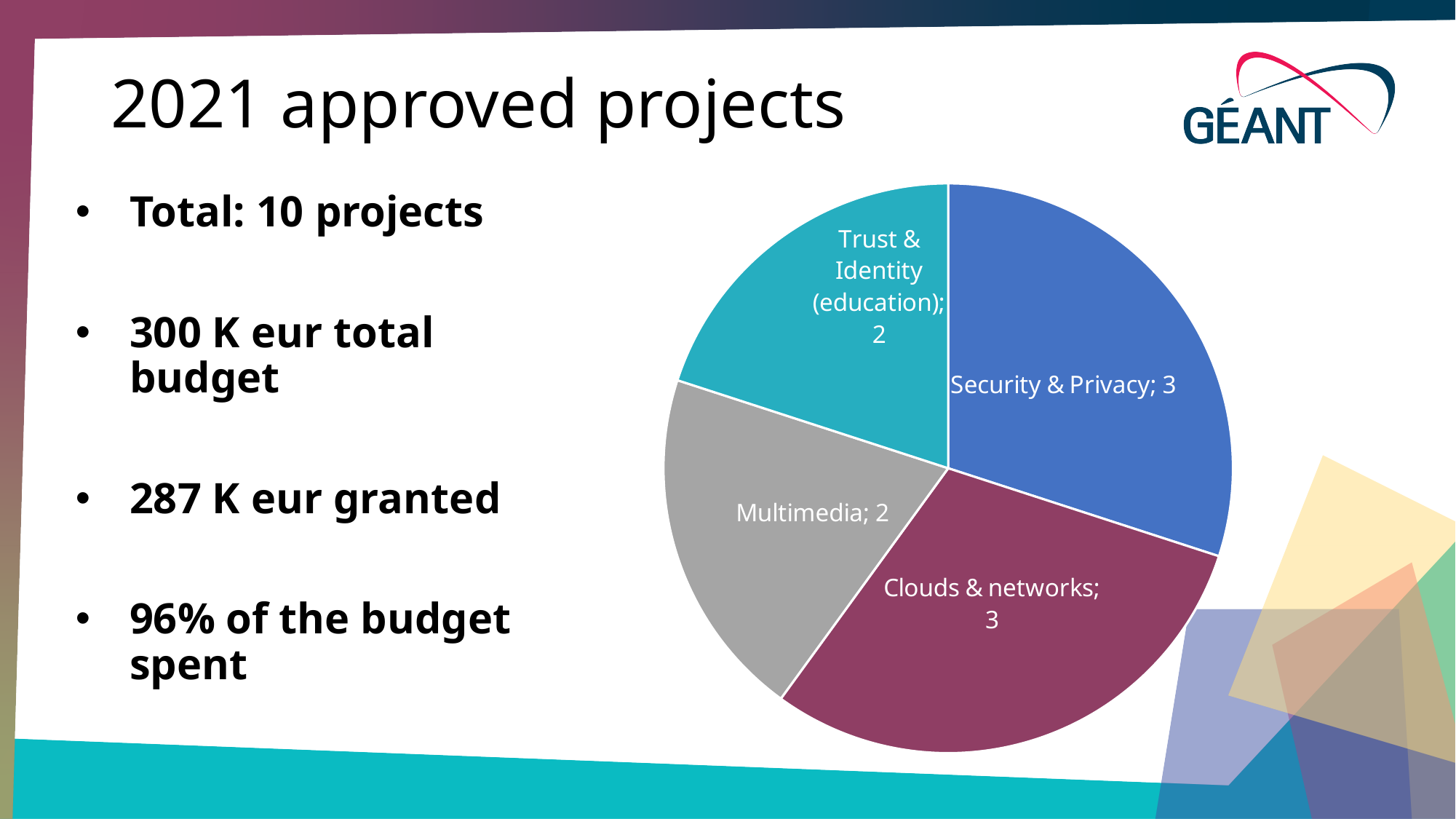
What share of the pie chart does Security & Privacy represent? 30% What share of the pie chart does Multimedia represent? 20% How many projects does the pie chart show for Multimedia? 2 How many projects does the pie chart show for Clouds & networks? 3 What is the difference between the number of Clouds & networks projects and Multimedia projects in the pie chart? 1 How many slices does the pie chart have? 4 How many projects does the pie chart show for Security & Privacy? 3 What colour is the Clouds & networks slice in the pie chart? dark magenta Which has more projects in the pie chart, Security & Privacy or Multimedia? Security & Privacy Which has more projects in the pie chart, Trust & Identity (education) or Clouds & networks? Clouds & networks How many projects does the pie chart show for Trust & Identity (education)? 2 What kind of chart is shown on the slide? pie chart